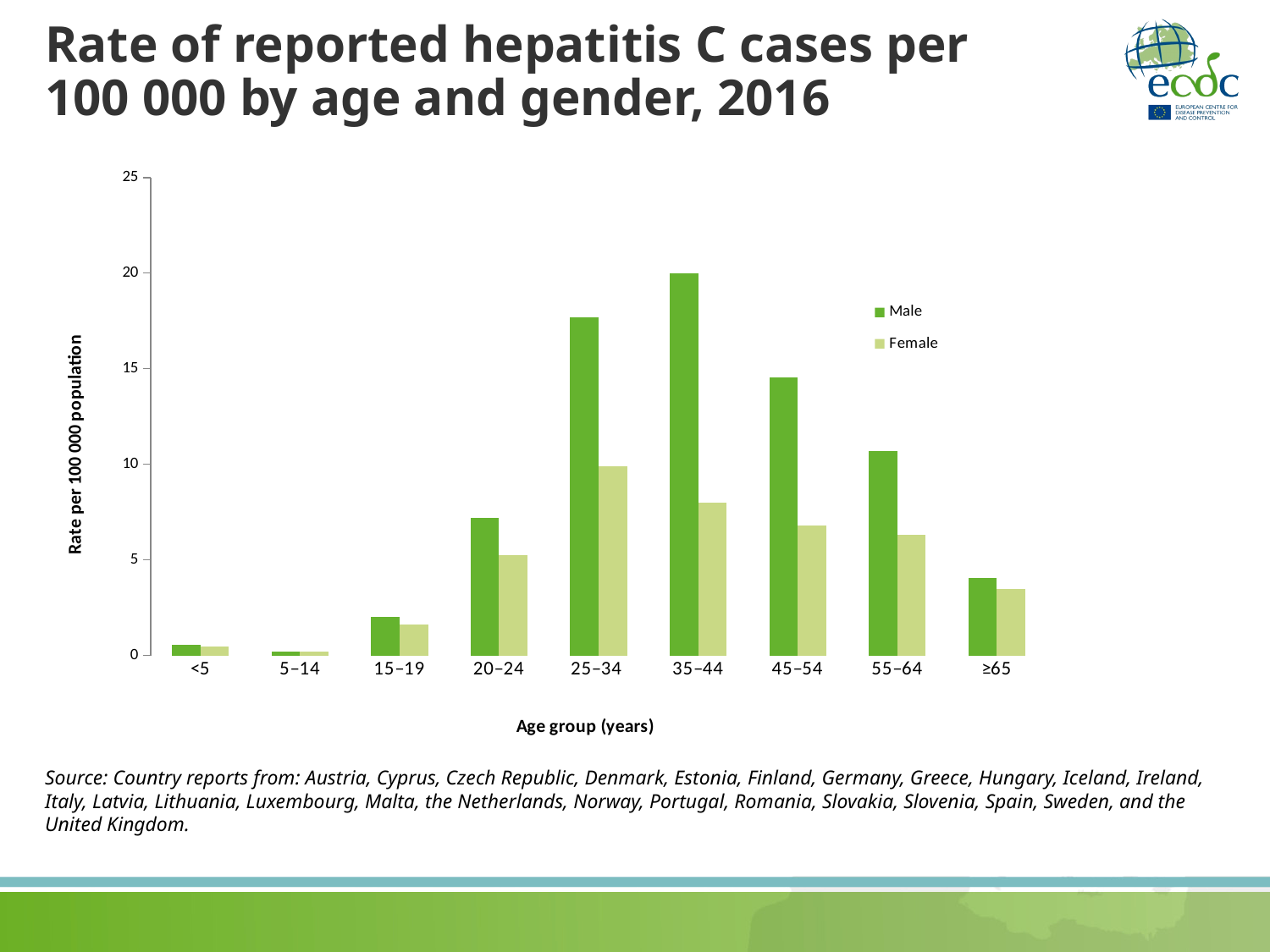
How many series does the legend list? 2 In the 45–54 age group, which is larger, the Male or the Female rate? Male Which age group has the lowest Male rate? 5–14 Do the Male values rise or fall along the x axis from the 35–44 age group to the ≥65 age group? fall Is the Male value for the 25–34 age group greater or less than 15? greater Is the Male value for the 55–64 age group greater or less than 10? greater How many age groups are shown on the x axis? 9 What kind of chart is shown on the slide? bar chart Which age group has the highest Male rate? 35–44 Is the Female value for the 35–44 age group greater or less than 10? less Which age group has the highest Female rate? 25–34 What is the title of the y axis? Rate per 100 000 population